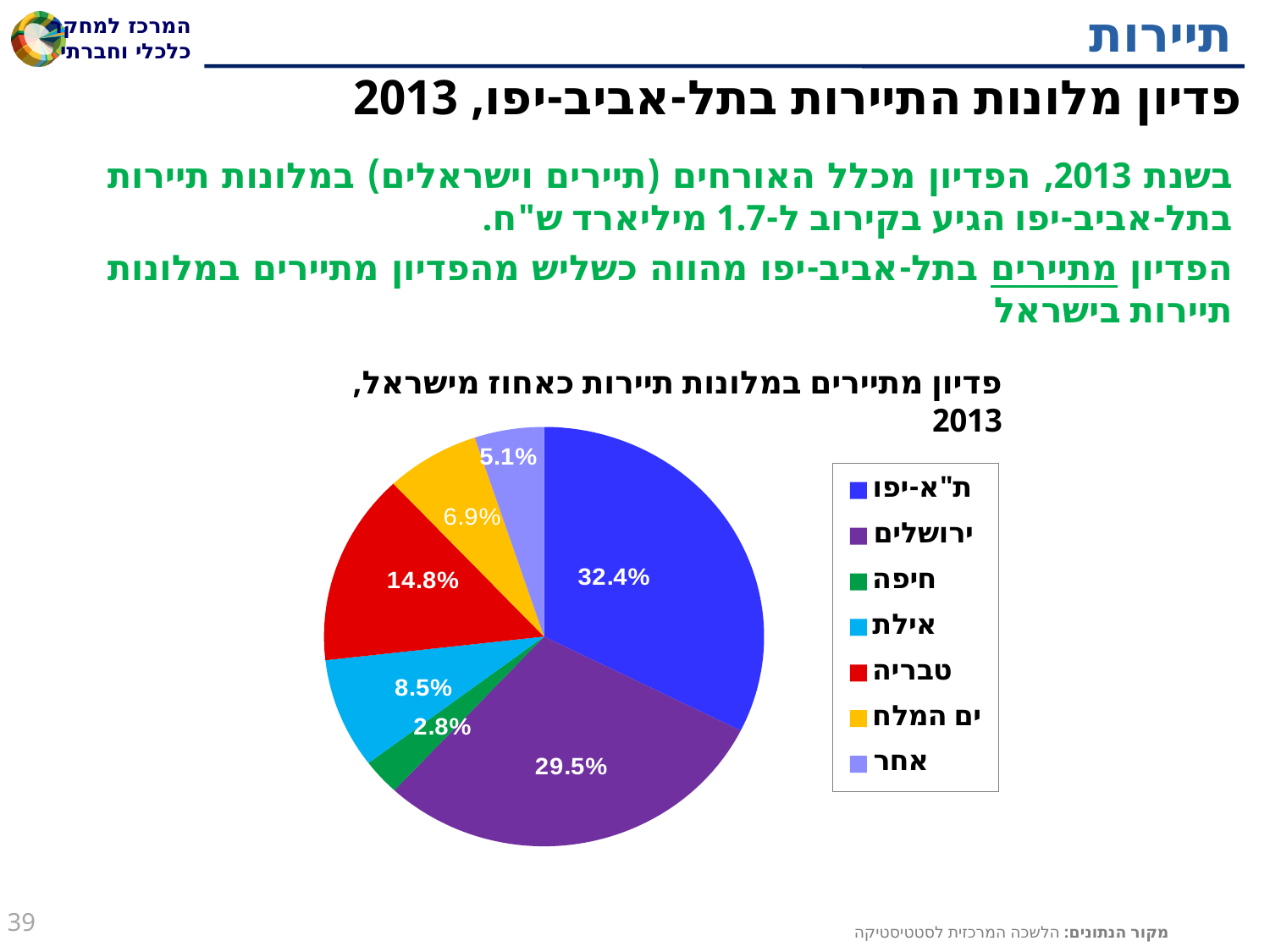
What is the share for ת"א-יפו in the pie chart? 32.4% What is the difference between the shares of ת"א-יפו and ירושלים? 2.9% Which category has the smallest slice in the pie chart? חיפה What is the share for ים המלח in the pie chart? 6.9% What is the share for טבריה in the pie chart? 14.8% How many categories does the legend of the pie chart list? 7 What colour is the slice for טבריה in the pie chart? Red Which has a larger share, אילת or ים המלח? אילת What is the share for ירושלים in the pie chart? 29.5% What is the share for חיפה in the pie chart? 2.8% Which category has the largest slice in the pie chart? ת"א-יפו What type of chart is shown on the slide? Pie chart